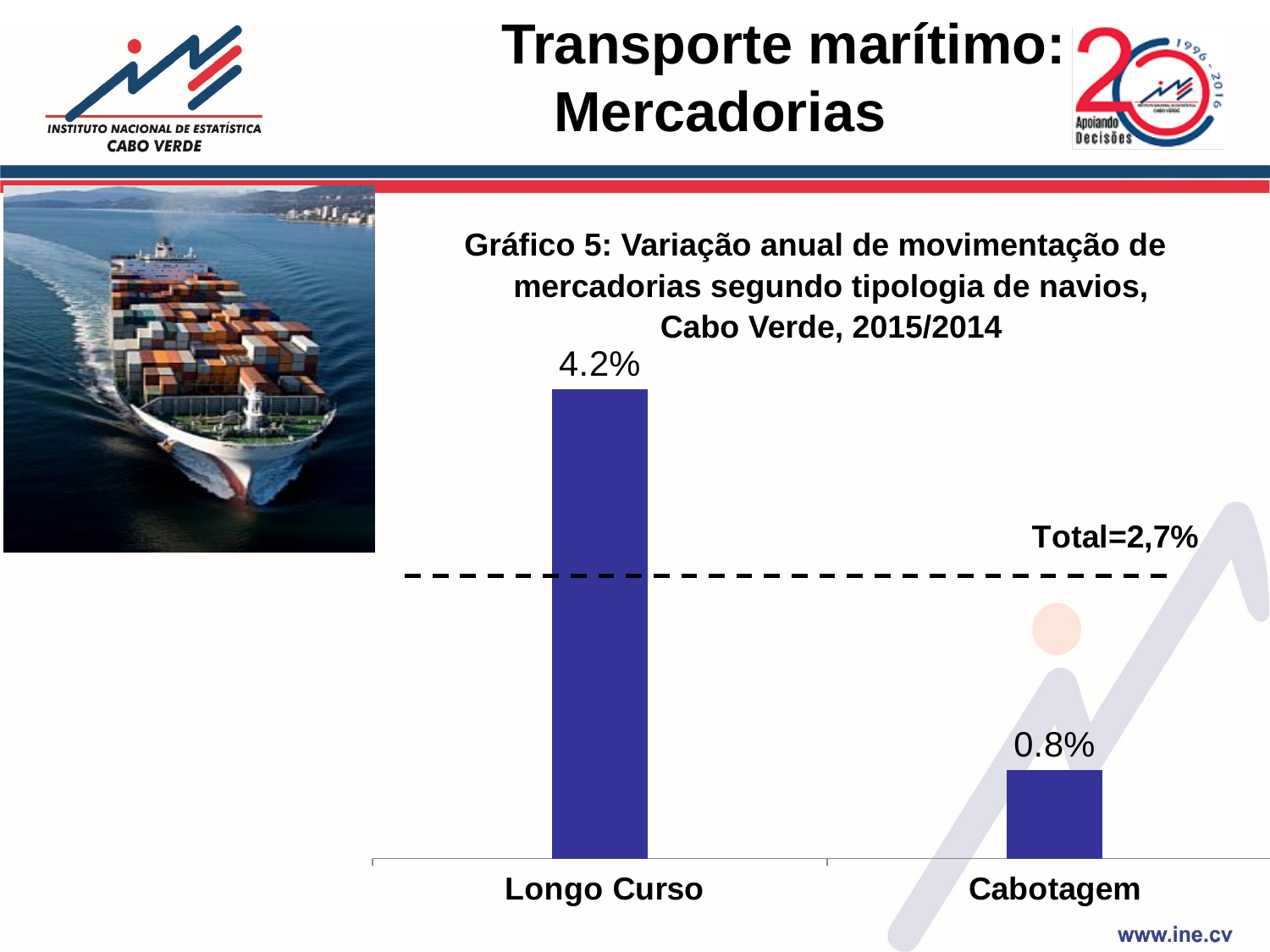
What is the difference between the values for Longo Curso and Cabotagem? 3.4% What is the value for Longo Curso? 4.2% What is the title of the chart? Gráfico 5: Variação anual de movimentação de mercadorias segundo tipologia de navios, Cabo Verde, 2015/2014 What kind of chart is shown on the slide? bar chart What total value is indicated by the dashed line on the chart? 2,7% How many categories are shown in the chart? 2 Which category has the lowest value? Cabotagem Which is larger, the value for Longo Curso or the value for Cabotagem? Longo Curso Which category has the highest value? Longo Curso Do the values rise or fall from Longo Curso to Cabotagem? fall What is the value for Cabotagem? 0.8%